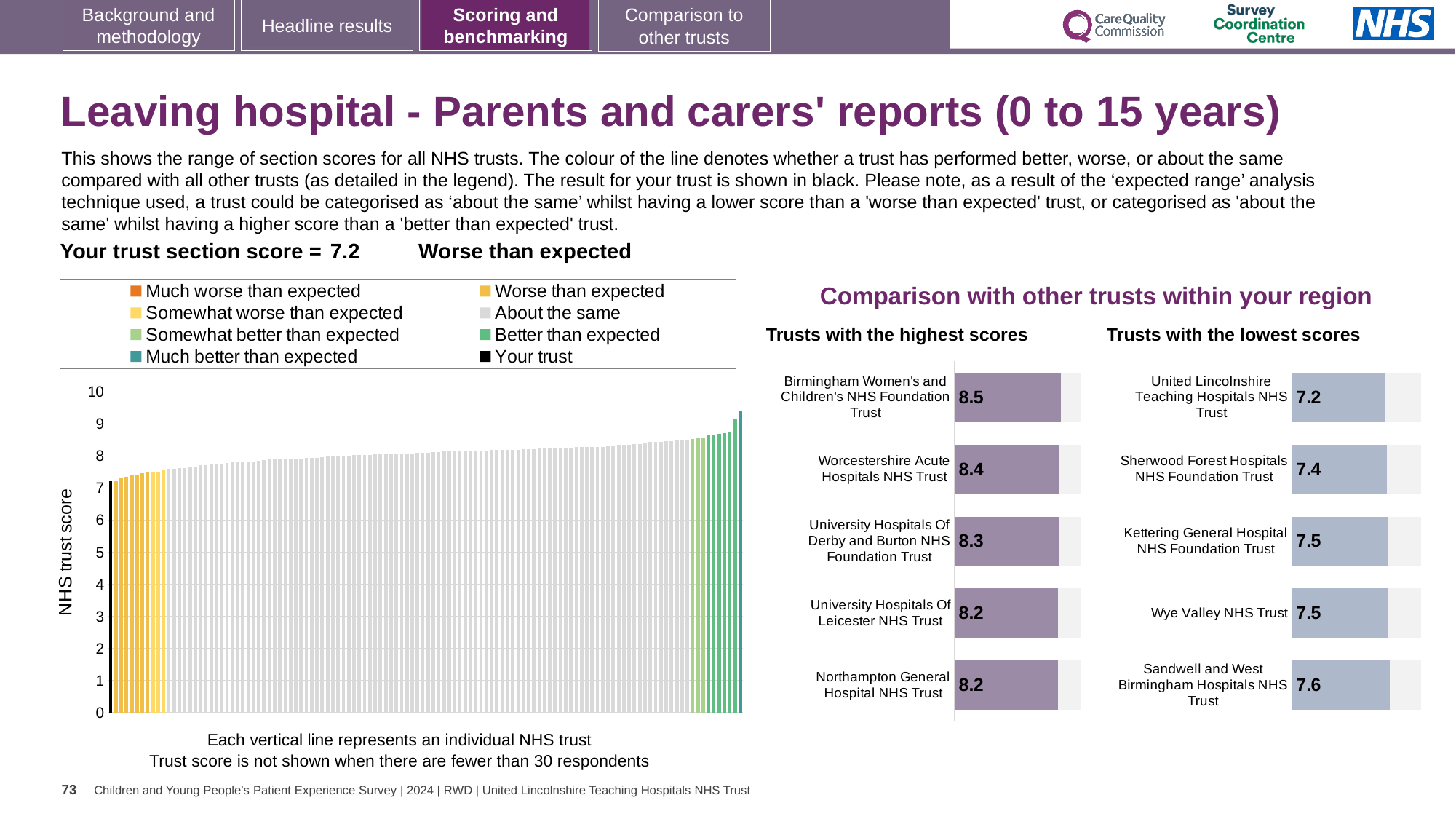
In the 'Trusts with the lowest scores' chart, which trust has the lowest score? United Lincolnshire Teaching Hospitals NHS Trust In the 'Trusts with the highest scores' chart, what is the difference between the scores of Birmingham Women's and Children's NHS Foundation Trust and Northampton General Hospital NHS Trust? 0.3 In the 'Trusts with the highest scores' chart, what is the score for Birmingham Women's and Children's NHS Foundation Trust? 8.5 In the 'Trusts with the lowest scores' chart, which has the higher score: Kettering General Hospital NHS Foundation Trust or Sherwood Forest Hospitals NHS Foundation Trust? Kettering General Hospital NHS Foundation Trust In the 'Trusts with the lowest scores' chart, what is the difference between the scores of Sandwell and West Birmingham Hospitals NHS Trust and United Lincolnshire Teaching Hospitals NHS Trust? 0.4 In the 'Trusts with the lowest scores' chart, what is the score for Sherwood Forest Hospitals NHS Foundation Trust? 7.4 In the large chart on the left, do the bar values rise or fall from left to right? rise How many trusts are shown in the 'Trusts with the lowest scores' chart? 5 In the large chart on the left showing the range of section scores, is the value of the tallest bar greater or less than 9? greater How many entries does the legend of the large chart on the left list? 8 In the 'Trusts with the highest scores' chart, which trust has the highest score? Birmingham Women's and Children's NHS Foundation Trust In the 'Trusts with the highest scores' chart, what is the score for University Hospitals Of Derby and Burton NHS Foundation Trust? 8.3